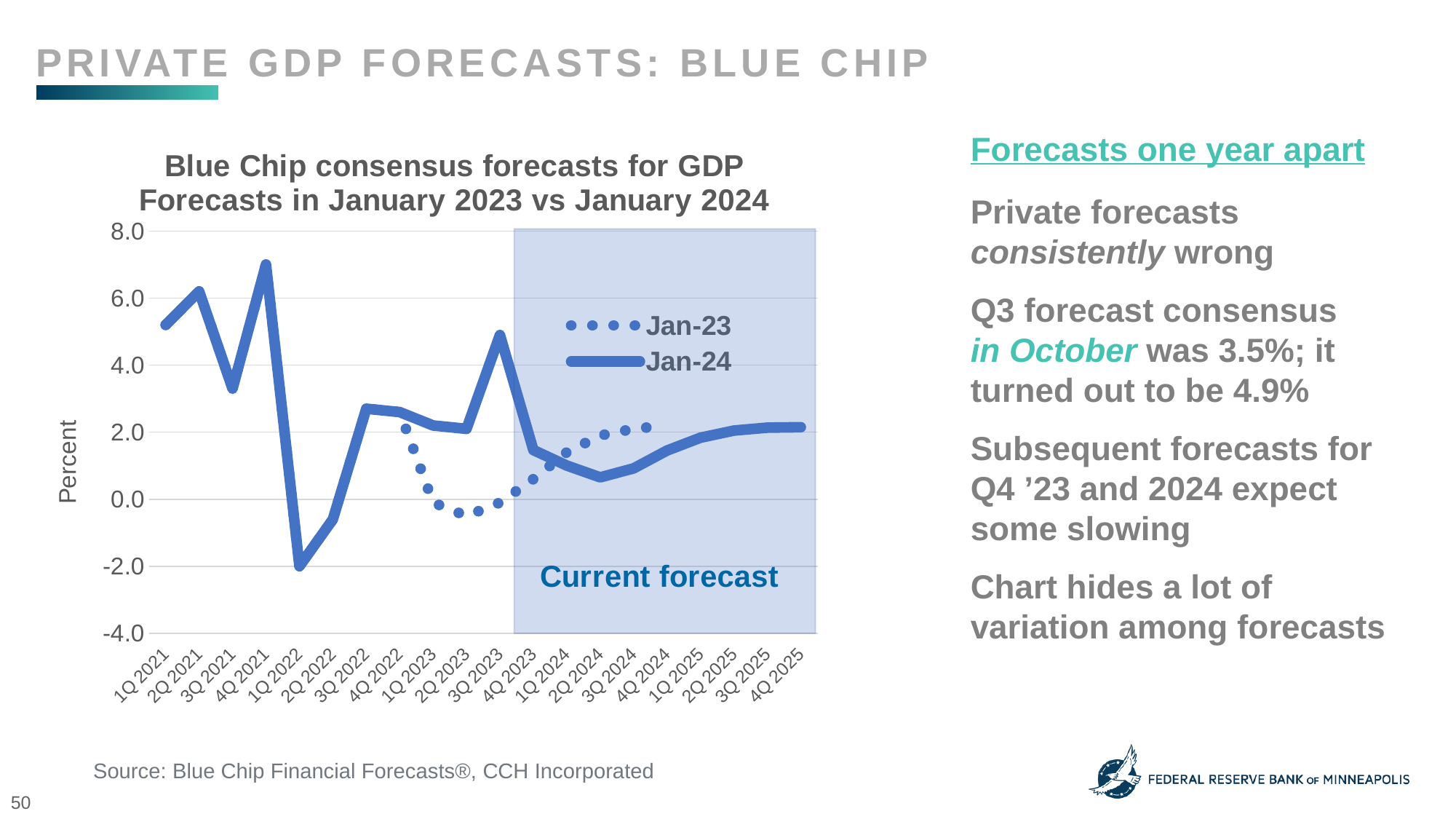
Does the Jan-24 series rise or fall from 2Q 2024 to 4Q 2025? Rise Is the Jan-24 value for 4Q 2021 greater or less than 6.0? greater At 3Q 2024, which series has the larger value, Jan-23 or Jan-24? Jan-23 Is the Jan-24 value for 1Q 2022 greater or less than 0.0? less How many series does the chart legend list? 2 Is the Jan-23 value for 2Q 2023 greater or less than 0.0? less At 2Q 2023, which series has the larger value, Jan-23 or Jan-24? Jan-24 What kind of chart is shown on the slide? Line chart In which quarter does the Jan-24 series reach its lowest value? 1Q 2022 In which quarter does the Jan-24 series reach its highest value? 4Q 2021 How many quarters are shown along the x axis of the chart? 20